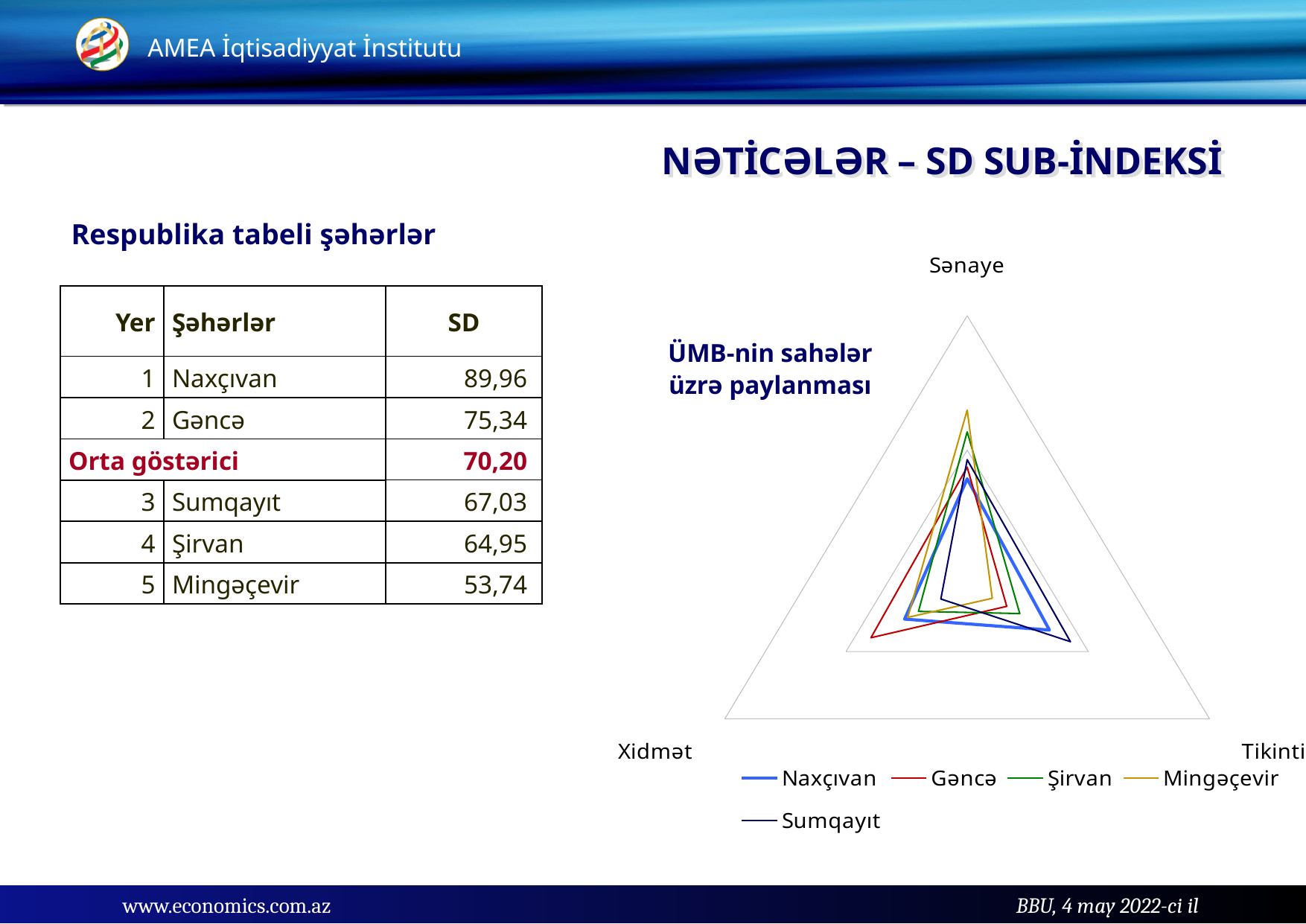
Which series is drawn in red on the radar chart? Gəncə Which series reaches the highest value on the Tikinti axis of the radar chart? Sumqayıt Which series reaches the highest value on the Sənaye axis of the radar chart? Mingəçevir How many series does the legend of the radar chart list? 5 Which series reaches the highest value on the Xidmət axis of the radar chart? Gəncə On the Sənaye axis, which is larger: the value for Mingəçevir or the value for Naxçıvan? Mingəçevir Which series has the lowest value on the Xidmət axis of the radar chart? Sumqayıt On the Tikinti axis, which is larger: the value for Sumqayıt or the value for Mingəçevir? Sumqayıt What are the three category labels on the radar chart? Sənaye, Tikinti, Xidmət How many axes (categories) does the radar chart have? 3 What kind of chart is shown on the slide? Radar chart